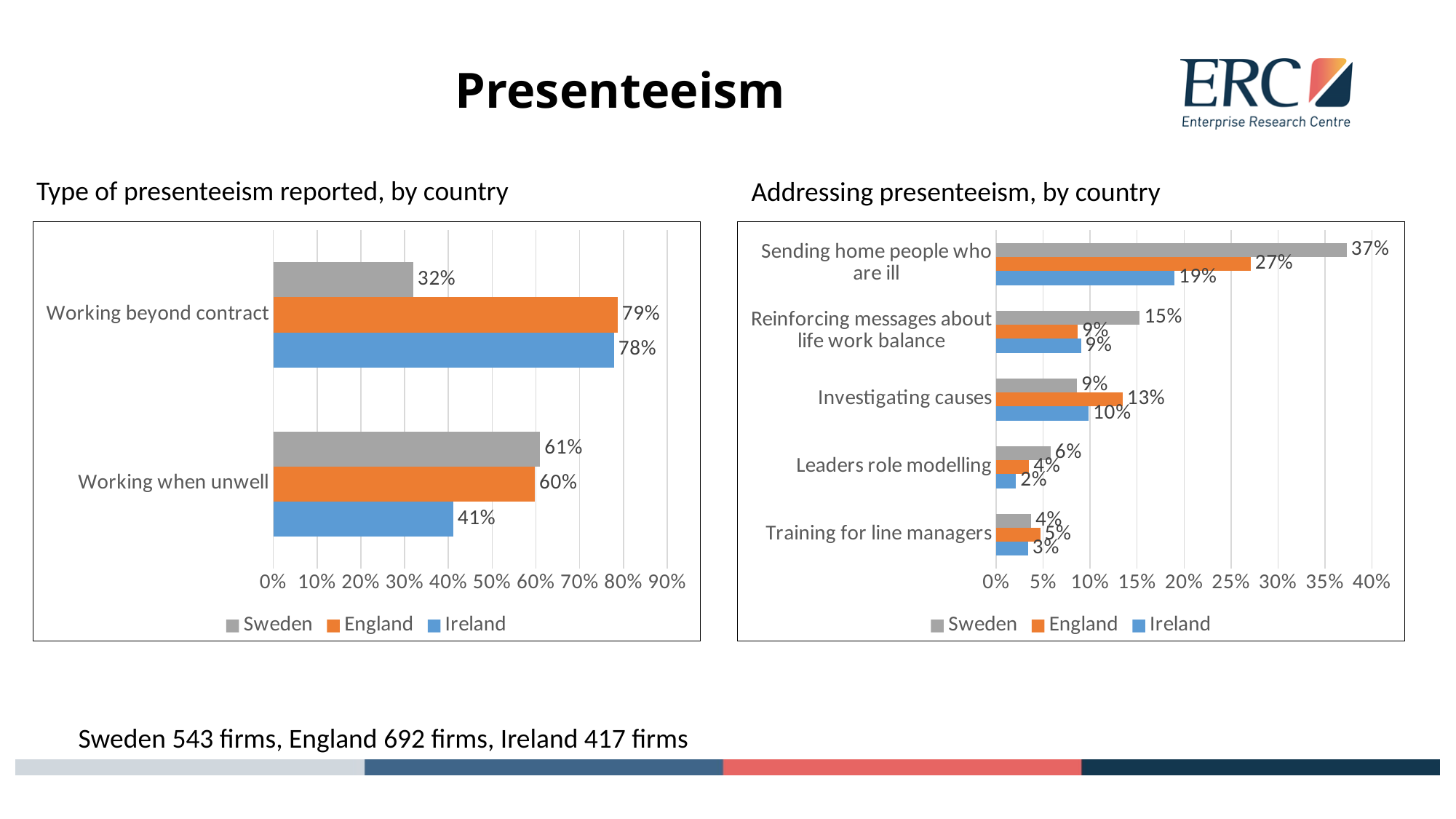
In the 'Addressing presenteeism, by country' chart, which is larger for Leaders role modelling: Sweden or Ireland? Sweden In the 'Addressing presenteeism, by country' chart, which country has the highest value for Sending home people who are ill? Sweden In the 'Type of presenteeism reported, by country' chart, what is the value for Ireland for Working when unwell? 41% In the 'Type of presenteeism reported, by country' chart, what is the difference between Sweden and Ireland for Working when unwell? 20% What kind of chart is the 'Addressing presenteeism, by country' chart? Bar chart In the 'Type of presenteeism reported, by country' chart, how many series does the legend list? 3 In the 'Type of presenteeism reported, by country' chart, what is the value for England for Working beyond contract? 79% In the 'Addressing presenteeism, by country' chart, what is the value for Sweden for Sending home people who are ill? 37% In the 'Type of presenteeism reported, by country' chart, which country has the lowest value for Working beyond contract? Sweden How many categories are shown in the 'Addressing presenteeism, by country' chart? 5 In the 'Addressing presenteeism, by country' chart, what is the difference between Sweden and Ireland for Sending home people who are ill? 18% In the 'Addressing presenteeism, by country' chart, what is the value for England for Investigating causes? 13%